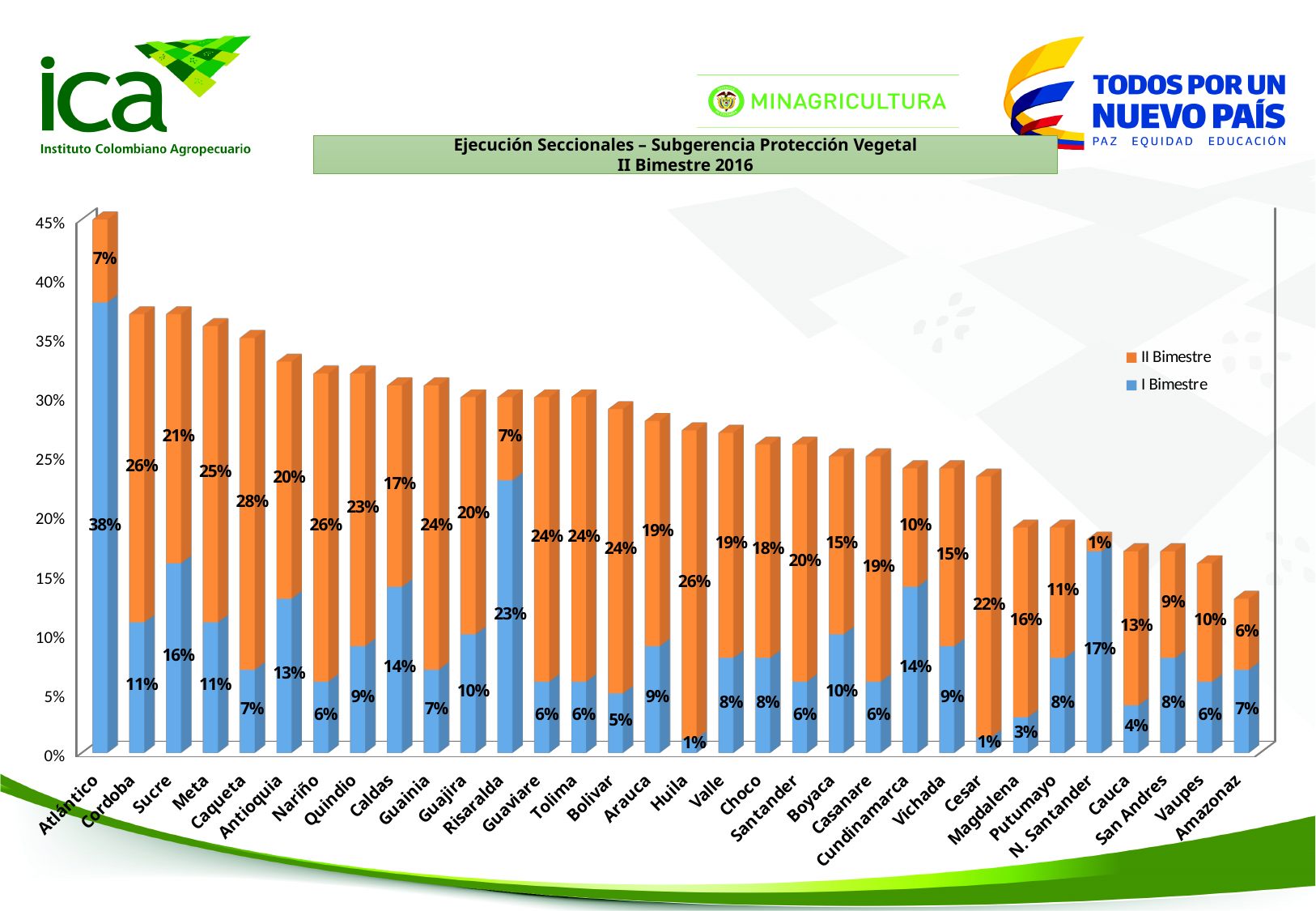
What is the total of the stacked bar for Amazonaz? 13% Which category has the highest I Bimestre value? Atlantico What is the II Bimestre value for Caqueta? 28% What is the total of the stacked bar for Huila? 27% What is the I Bimestre value for Atlantico? 38% What is the difference between the II Bimestre values for Cordoba and Sucre? 5% How many categories are shown on the x axis? 32 What is the I Bimestre value for Risaralda? 23% Which is larger, the I Bimestre value for Cundinamarca or the I Bimestre value for Vichada? Cundinamarca How many series does the legend list? 2 What kind of chart is shown on the slide? Stacked bar chart Which category has the lowest II Bimestre value? N. Santander